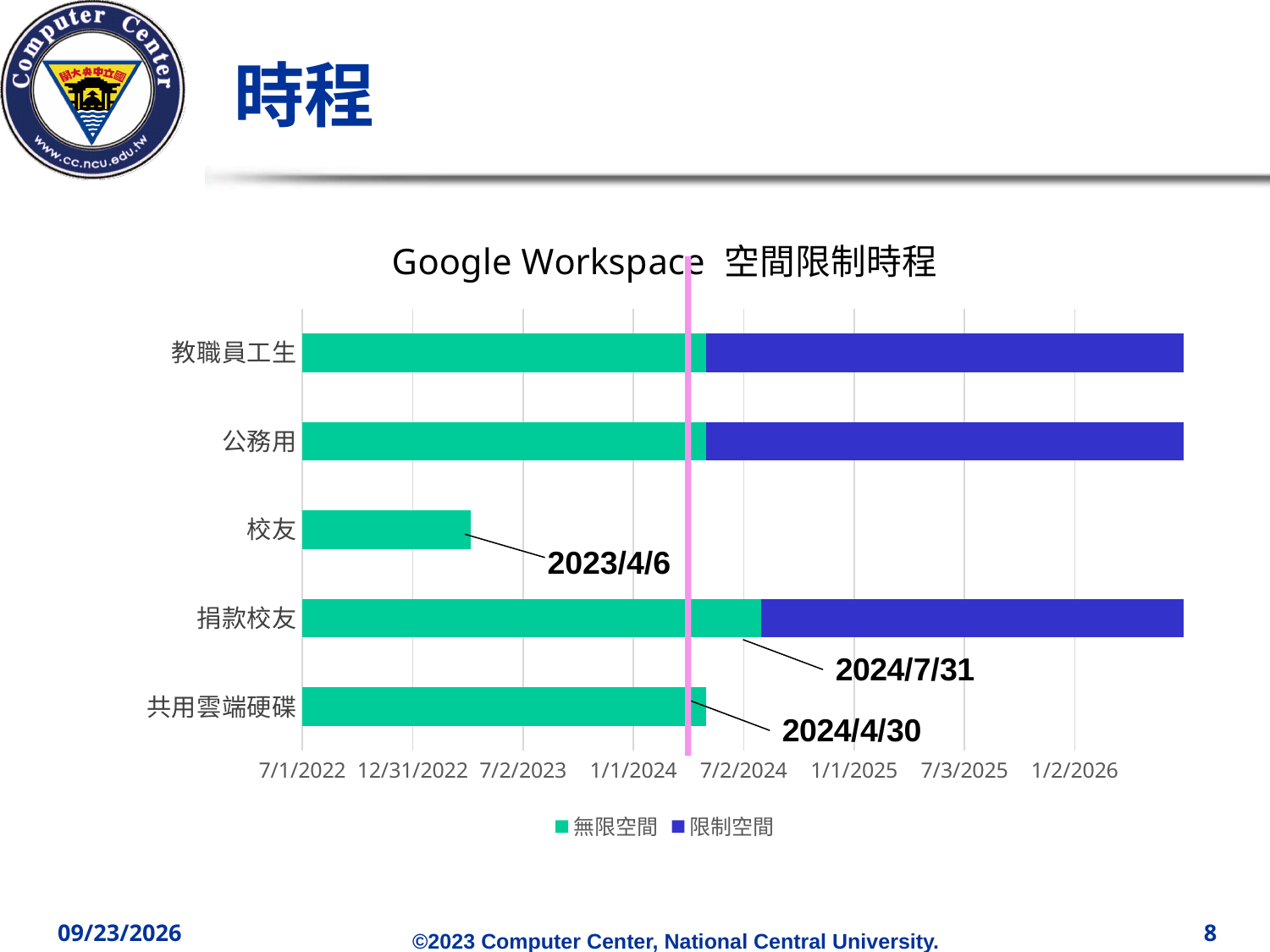
Which category has the shortest 無限空間 bar? 校友 How many series does the chart legend list? 2 What is the title of the chart? Google Workspace 空間限制時程 How many categories are listed on the vertical axis of the chart? 5 What date is annotated at the end of the 校友 bar? 2023/4/6 What date is annotated at the end of the 共用雲端硬碟 bar? 2024/4/30 Which series is shown in green in the chart? 無限空間 What date is annotated where the 捐款校友 bar changes from 無限空間 to 限制空間? 2024/7/31 How many categories have a 限制空間 segment in the chart? 3 What kind of chart is shown on the slide? bar chart Which category's 無限空間 bar extends furthest to the right? 捐款校友 Does the 無限空間 period for 校友 end before or after the 無限空間 period for 捐款校友? before